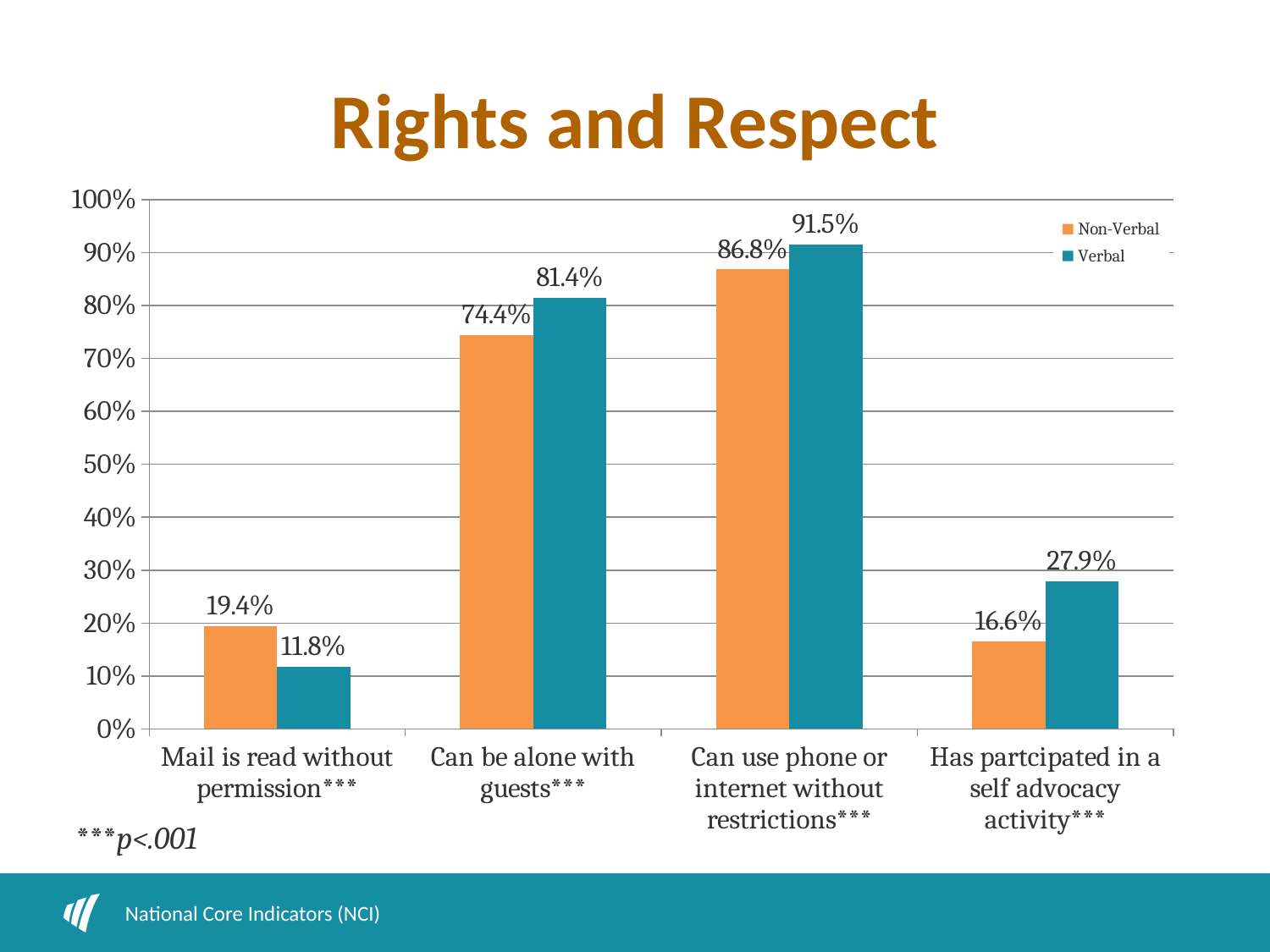
What is the Verbal value for "Has partcipated in a self advocacy activity"? 27.9% What kind of chart is shown on the slide? Bar chart What is the difference between the Verbal and Non-Verbal values for "Can be alone with guests"? 7.0% What is the Non-Verbal value for "Can be alone with guests"? 74.4% For "Mail is read without permission", which series has the larger value, Non-Verbal or Verbal? Non-Verbal What is the Verbal value for "Mail is read without permission"? 11.8% Which category has the highest Verbal value? Can use phone or internet without restrictions What is the title of the chart? Rights and Respect How many categories are shown on the x axis? 4 Which category has the lowest Non-Verbal value? Has partcipated in a self advocacy activity How many series does the legend list? 2 Is the Non-Verbal value for "Can use phone or internet without restrictions" greater or less than 80%? greater